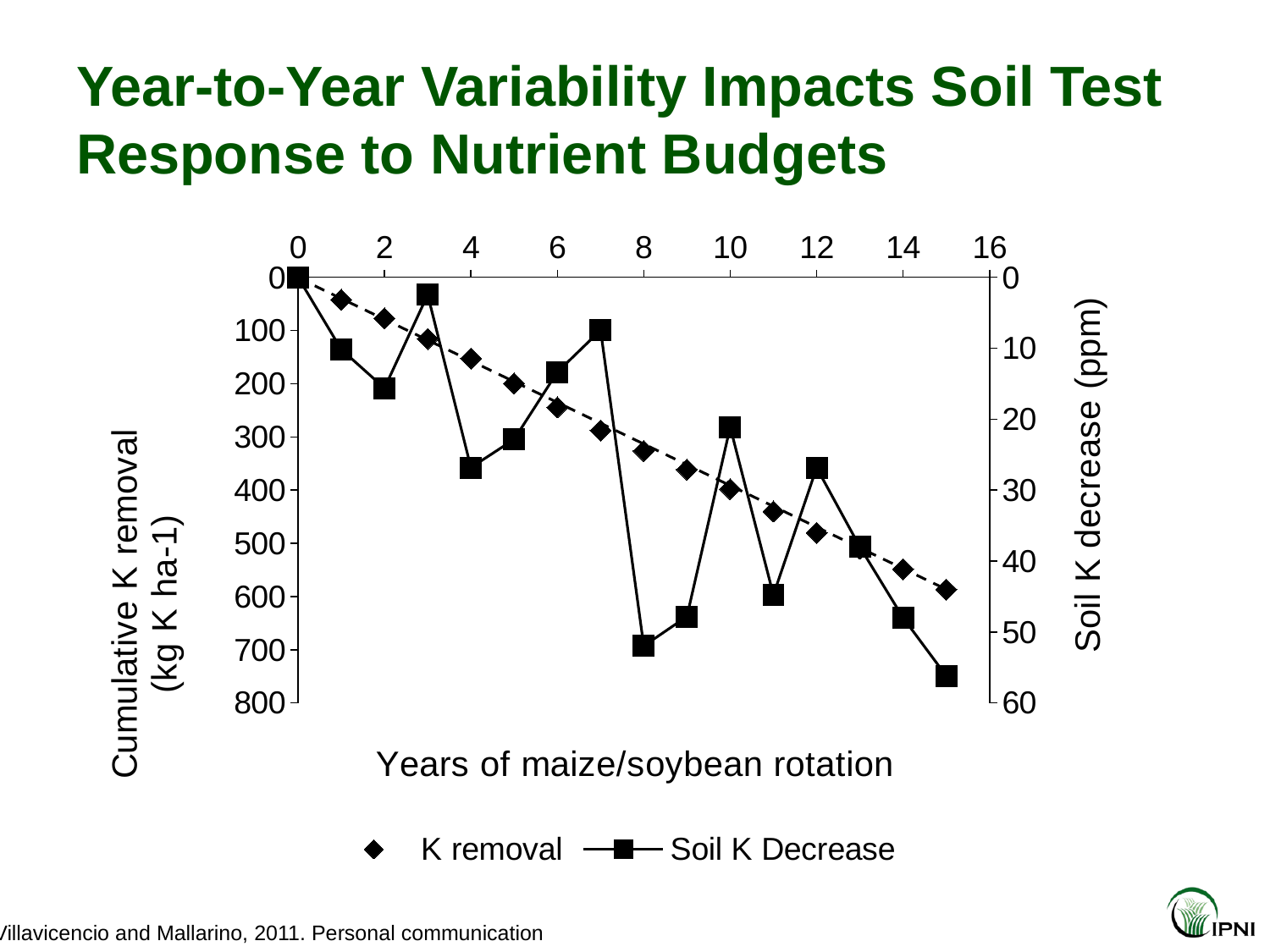
Is the Soil K Decrease value at year 4 greater or less than 20 ppm? greater What kind of chart is shown on the slide? line chart Is the Soil K Decrease value at year 15 greater or less than 50 ppm? greater How many series does the legend list? 2 Which two series are listed in the chart legend? K removal and Soil K Decrease Does cumulative K removal increase or decrease as the years of rotation increase? increase How many data points are plotted for the Soil K Decrease series? 16 Which year has the highest Soil K Decrease value? 15 Is the cumulative K removal value at year 15 greater or less than 500 kg K ha-1? greater What is the x-axis title of the chart? Years of maize/soybean rotation